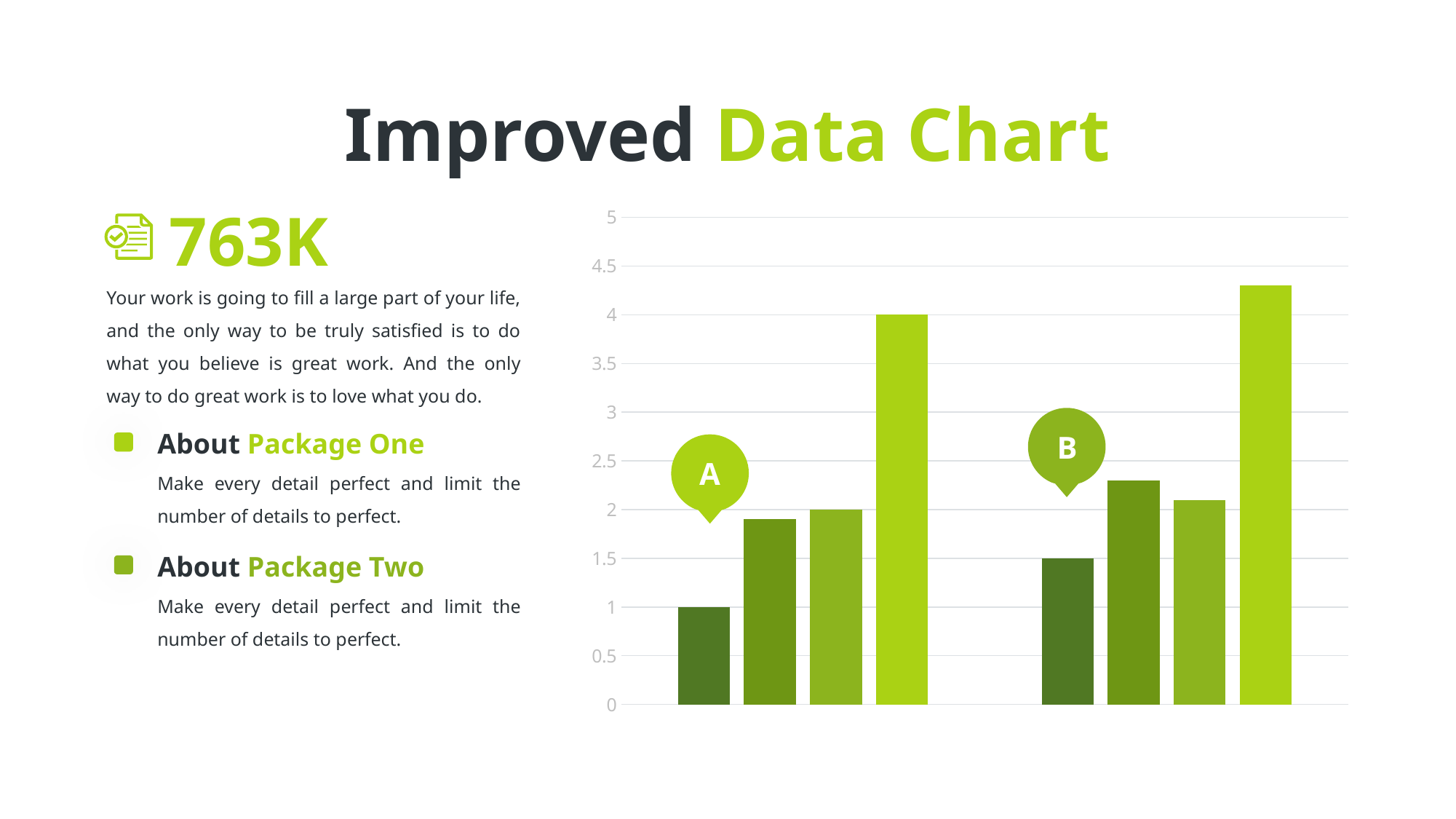
What is the value of the first (darkest green) bar in group A? 1 What is the highest value shown on the y-axis? 5 Which is the shortest bar on the chart? the first bar in group A How many labelled groups of bars does the chart show? 2 How many bars are in group A? 4 Which group, A or B, contains the tallest bar on the chart? B What is the value of the tallest (lightest green) bar in group A? 4 What kind of chart is shown on the slide? bar chart What is the difference between the tallest bar and the shortest bar in group A? 3 What is the value of the first (darkest green) bar in group B? 1.5 Is the value of the second bar in group A greater or less than 1.5? greater Is the value of the tallest bar in group B greater or less than 4? greater